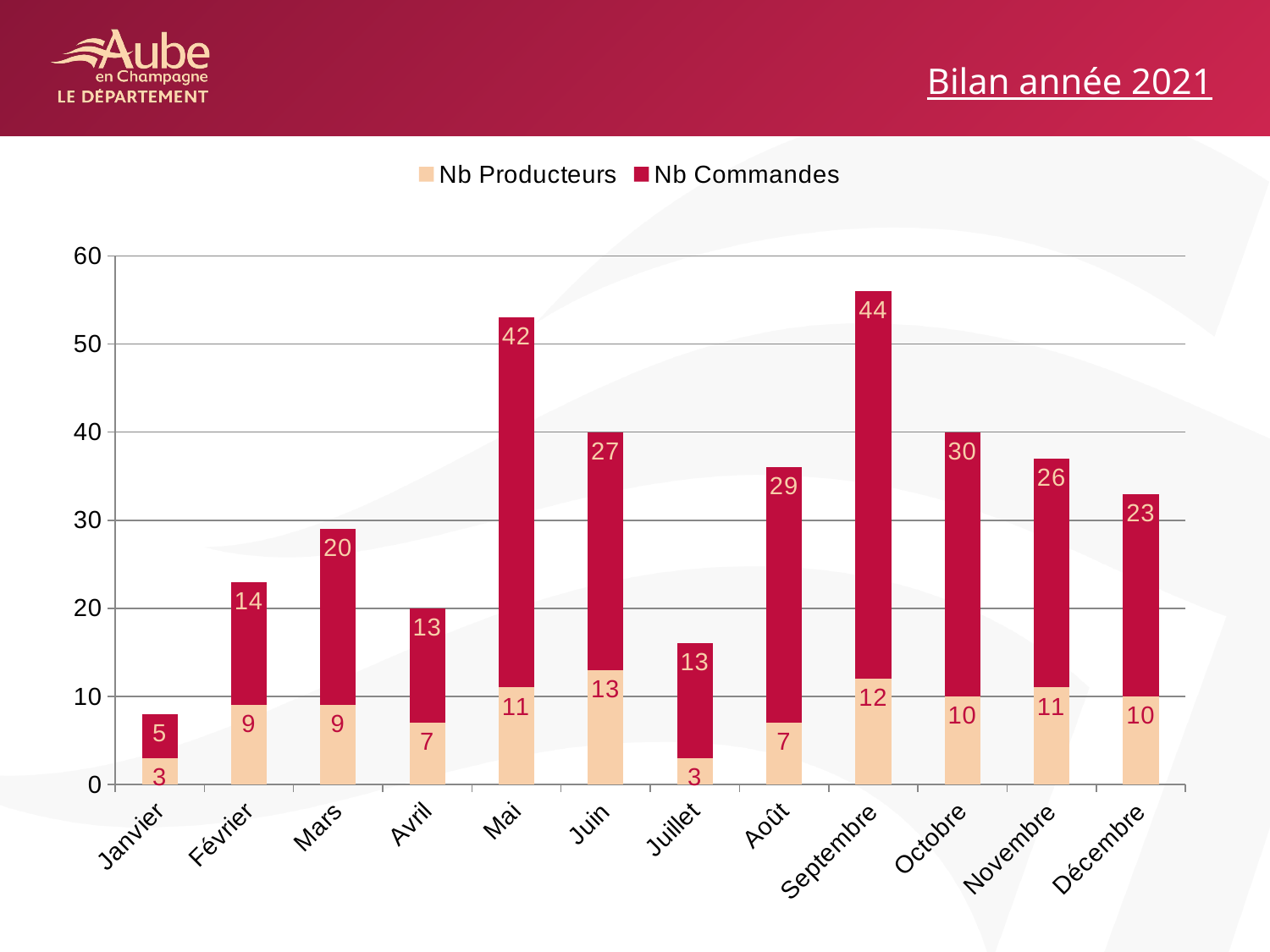
What is the Nb Producteurs value for Juin? 13 Which is larger, the Nb Commandes value for Octobre or for Novembre? Octobre Which series is shown in dark red in the legend? Nb Commandes Which month has the highest Nb Commandes value? Septembre What is the total of the stacked bar for Septembre? 56 How many series does the legend list? 2 What is the total of the stacked bar for Janvier? 8 Which month has the lowest Nb Commandes value? Janvier What is the difference between the Nb Commandes values for Septembre and Mai? 2 What is the Nb Commandes value for Mai? 42 What kind of chart is shown on the slide? Stacked bar chart How many months are shown on the x axis? 12